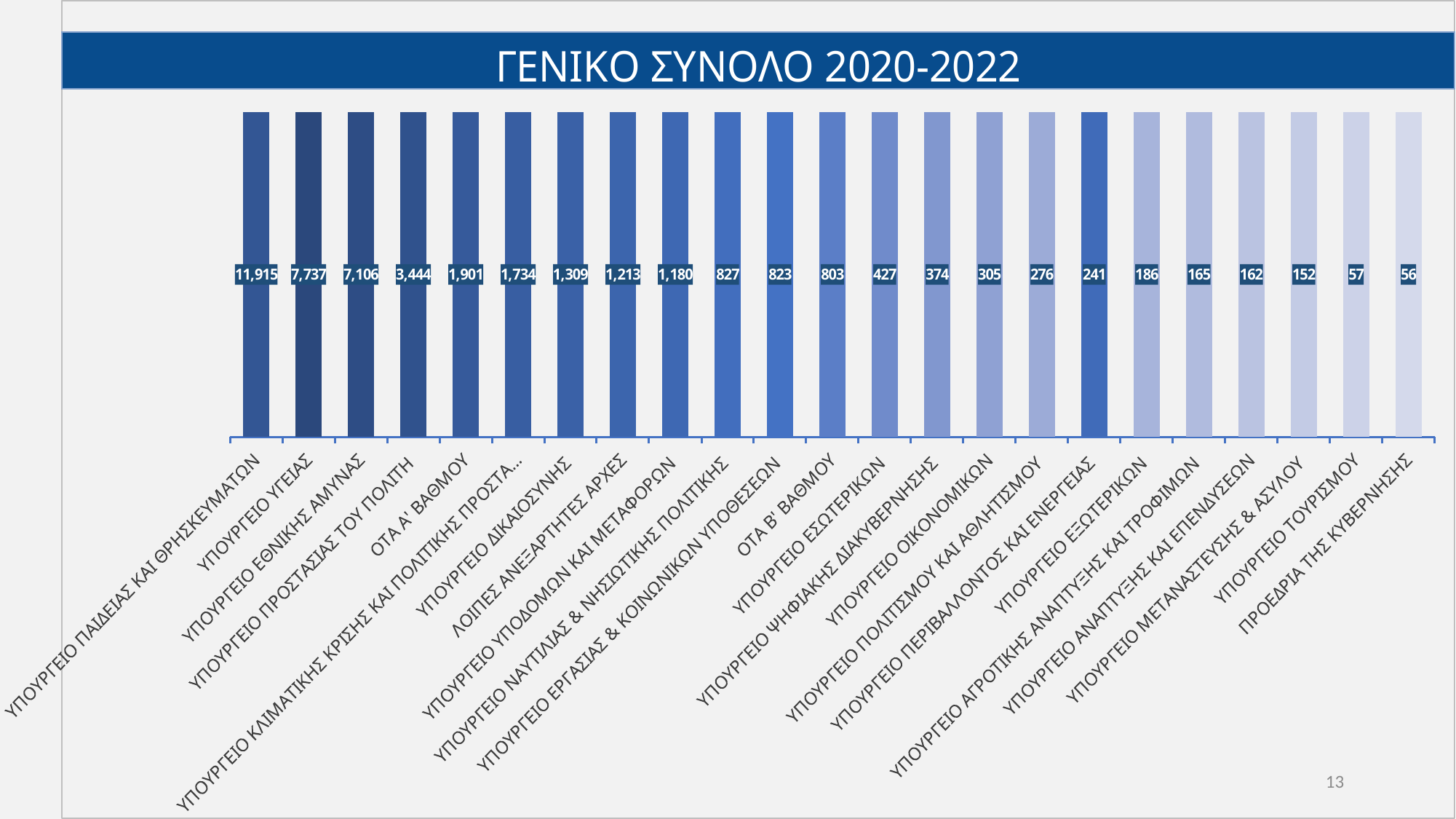
Which has a larger value, ΥΠΟΥΡΓΕΙΟ ΔΙΚΑΙΟΣΥΝΗΣ or ΥΠΟΥΡΓΕΙΟ ΕΣΩΤΕΡΙΚΩΝ? ΥΠΟΥΡΓΕΙΟ ΔΙΚΑΙΟΣΥΝΗΣ Which category has the lowest value? ΠΡΟΕΔΡΙΑ ΤΗΣ ΚΥΒΕΡΝΗΣΗΣ What is the difference between the values for ΥΠΟΥΡΓΕΙΟ ΥΓΕΙΑΣ and ΥΠΟΥΡΓΕΙΟ ΕΘΝΙΚΗΣ ΑΜΥΝΑΣ? 631 How many categories are shown in the chart? 23 Do the labelled values rise or fall from left to right along the x axis? fall What type of chart is shown on the slide? bar chart Which category has the highest value? ΥΠΟΥΡΓΕΙΟ ΠΑΙΔΕΙΑΣ ΚΑΙ ΘΡΗΣΚΕΥΜΑΤΩΝ What is the value for ΥΠΟΥΡΓΕΙΟ ΥΓΕΙΑΣ? 7,737 What is the value for ΥΠΟΥΡΓΕΙΟ ΠΑΙΔΕΙΑΣ ΚΑΙ ΘΡΗΣΚΕΥΜΑΤΩΝ? 11,915 What is the value for ΟΤΑ Β' ΒΑΘΜΟΥ? 803 What is the title of the chart? ΓΕΝΙΚΟ ΣΥΝΟΛΟ 2020-2022 What is the value for ΥΠΟΥΡΓΕΙΟ ΤΟΥΡΙΣΜΟΥ? 57